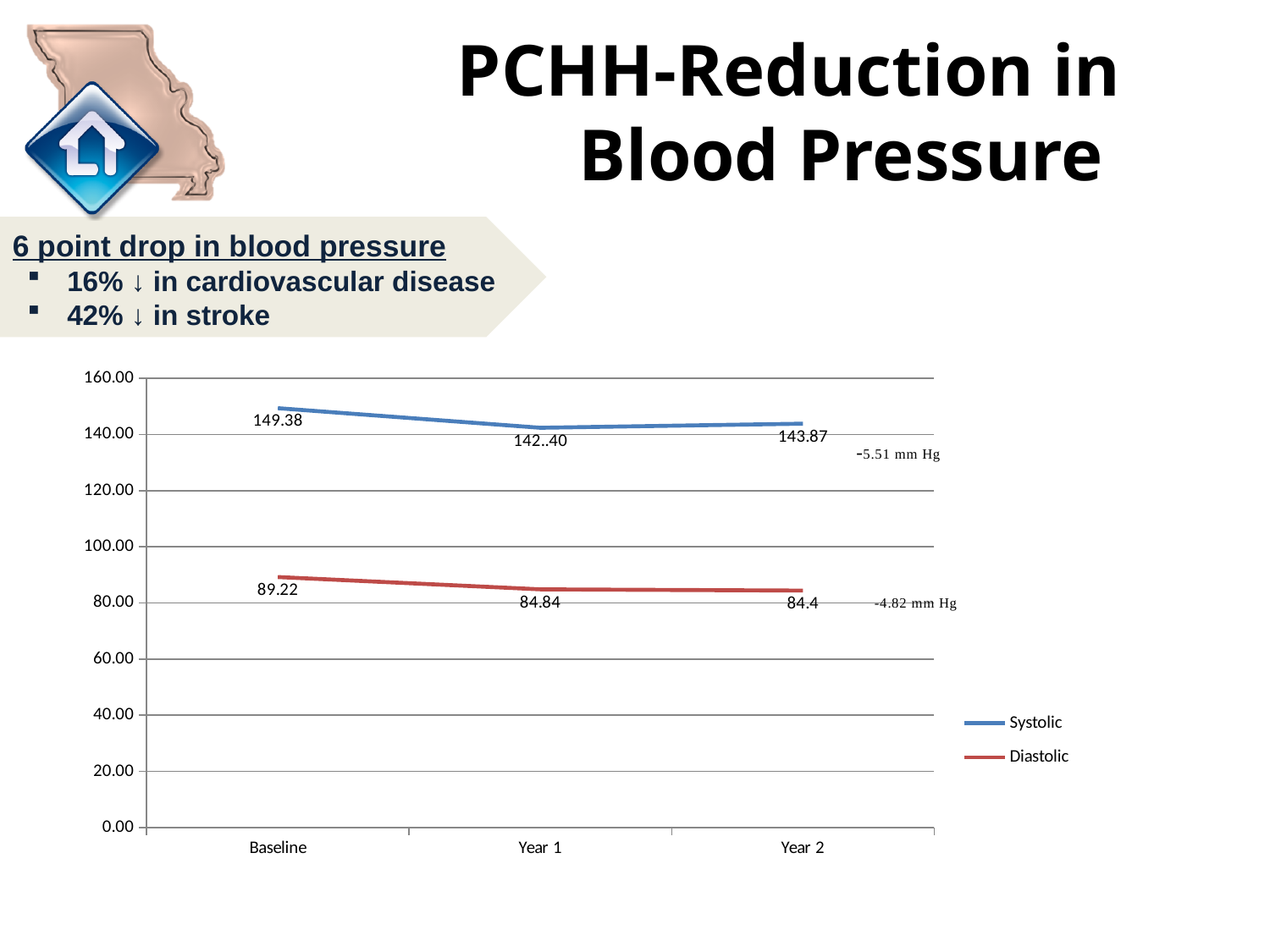
How many time points are shown on the x axis? 3 Which series is drawn in blue? Systolic What is the Diastolic value at Year 1? 84.84 How many series does the legend list? 2 What is the difference between the Systolic value at Baseline and at Year 2? 5.51 What is the Diastolic value at Year 2? 84.4 What is the Diastolic value at Baseline? 89.22 What is the Systolic value at Year 2? 143.87 What is the difference between the Diastolic value at Baseline and at Year 2? 4.82 What type of chart is shown on the slide? line chart At which time point is the Systolic value highest? Baseline What is the Systolic value at Baseline? 149.38